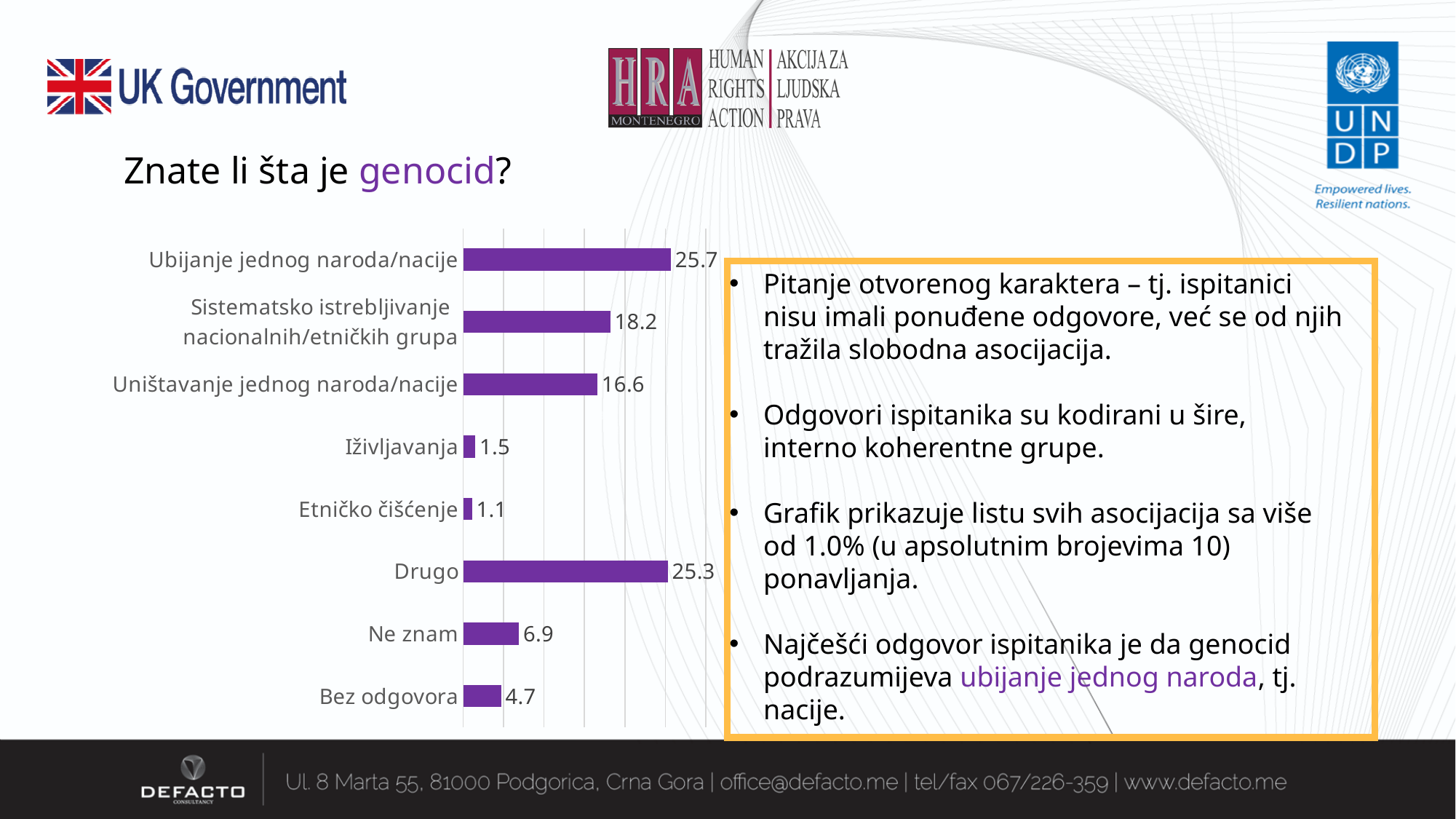
What kind of chart is shown on the slide? Bar chart What is the value for "Ubijanje jednog naroda/nacije"? 25.7 What colour are the bars in the chart? Purple What is the value for "Ne znam"? 6.9 What is the difference between the values for "Ne znam" and "Bez odgovora"? 2.2 Which category has the lowest value? Etničko čišćenje What is the value for "Bez odgovora"? 4.7 How many categories are shown in the chart? 8 Which category has the highest value? Ubijanje jednog naroda/nacije What is the difference between the values for "Sistematsko istrebljivanje nacionalnih/etničkih grupa" and "Uništavanje jednog naroda/nacije"? 1.6 What is the value for "Etničko čišćenje"? 1.1 Which is larger, the value for "Drugo" or the value for "Uništavanje jednog naroda/nacije"? Drugo